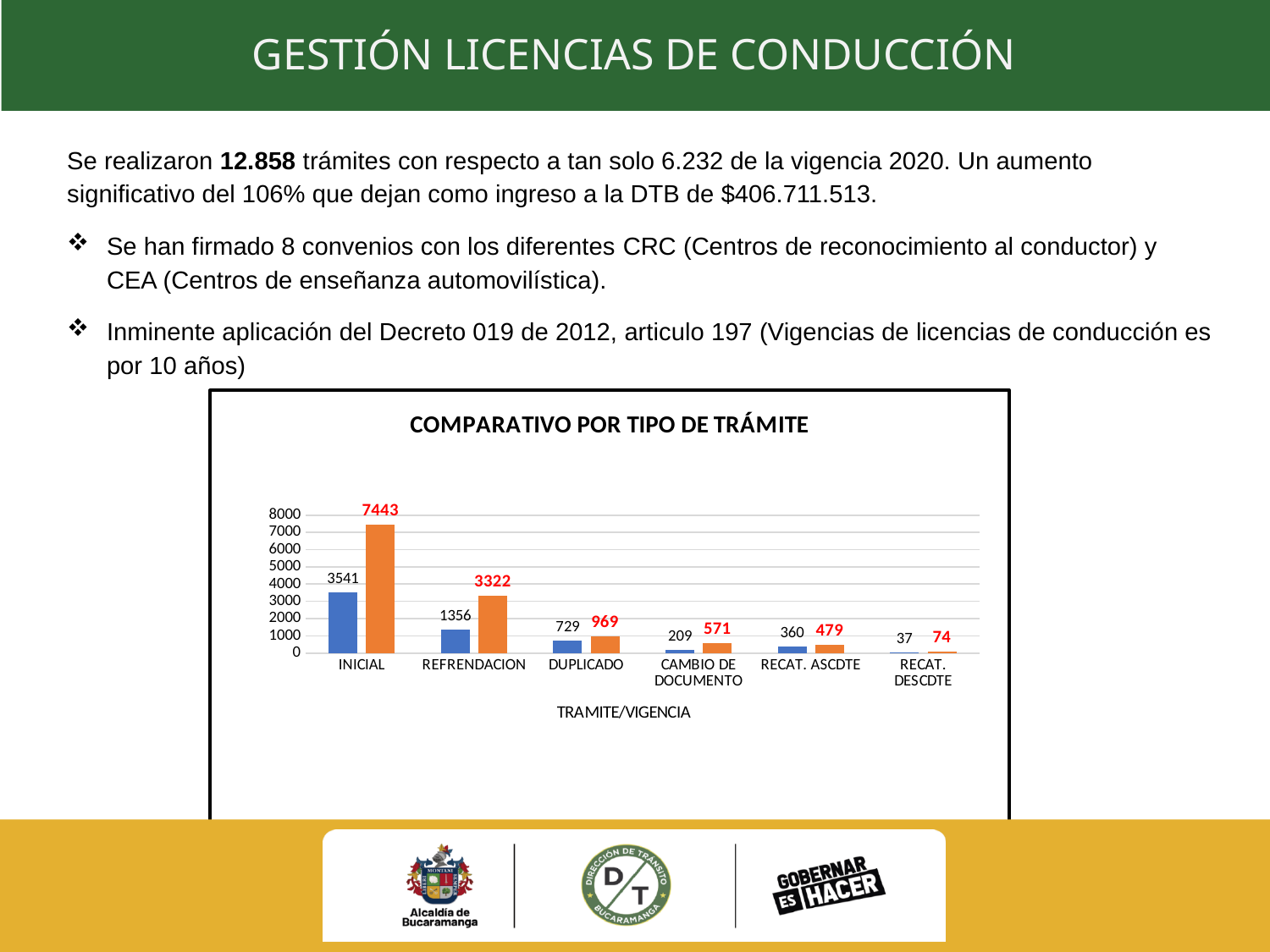
What is the x-axis label of the chart? TRAMITE/VIGENCIA What is the value of the orange bar for INICIAL? 7443 Which category has the lowest blue bar? RECAT. DESCDTE What is the difference between the orange and blue bars for INICIAL? 3902 What is the value of the orange bar for CAMBIO DE DOCUMENTO? 571 What type of chart is shown on the slide? bar chart Which is larger for DUPLICADO, the blue bar or the orange bar? the orange bar Which category has the highest orange bar? INICIAL What is the value of the blue bar for RECAT. DESCDTE? 37 How many categories are shown on the x axis of the chart? 6 What is the title of the chart on the slide? COMPARATIVO POR TIPO DE TRÁMITE What is the value of the blue bar for REFRENDACION? 1356